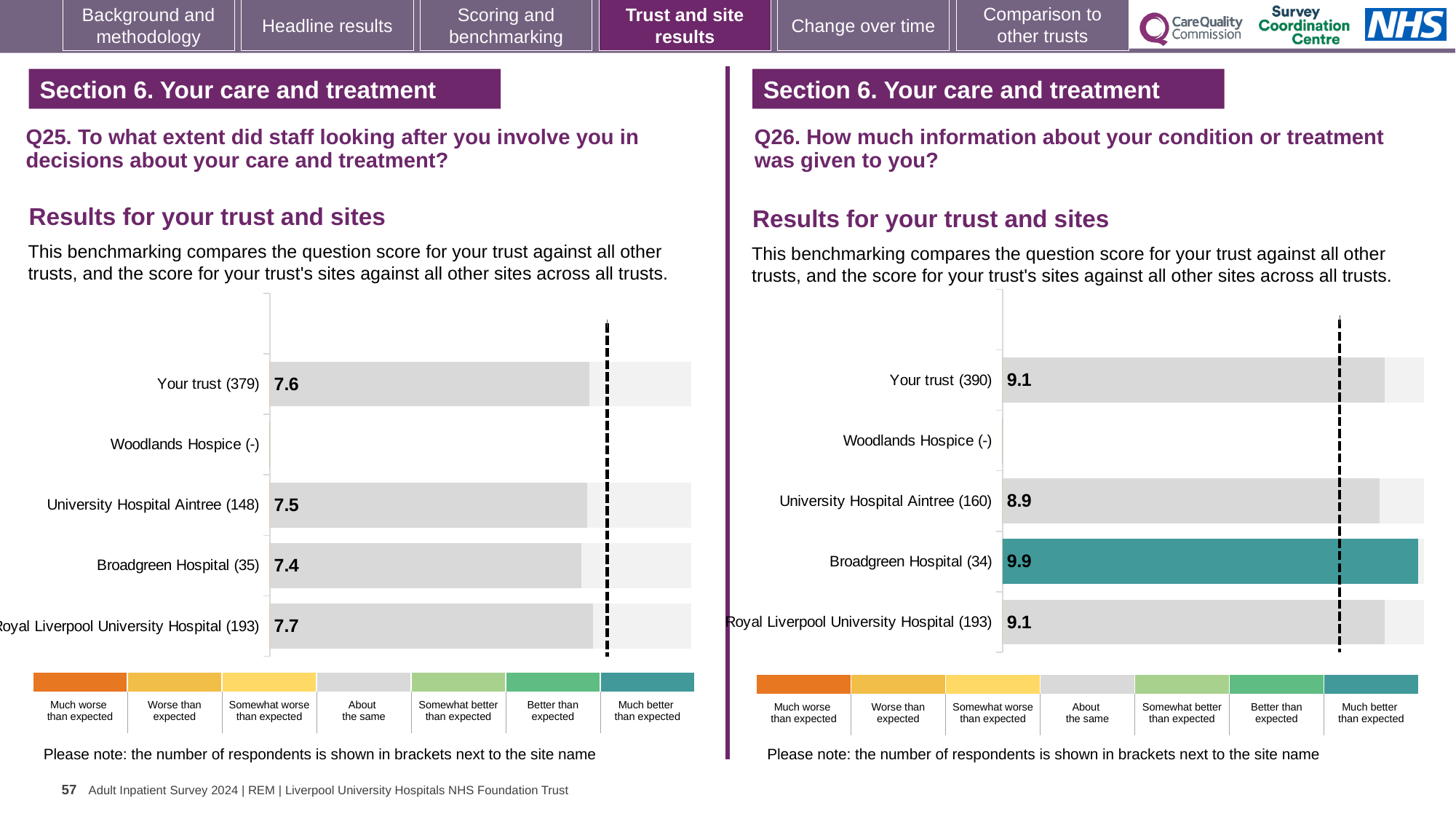
In the Q25 chart on the left, what is the score for Broadgreen Hospital? 7.4 In the Q25 chart on the left, what is the difference between the scores for Royal Liverpool University Hospital and Broadgreen Hospital? 0.3 In the Q26 chart on the right, what is the difference between the scores for Broadgreen Hospital and University Hospital Aintree? 1.0 In the Q26 chart on the right, which site or trust has the highest score? Broadgreen Hospital How many site or trust labels are listed on the Q25 chart on the left? 5 In the Q25 chart on the left, which site or trust has the lowest score? Broadgreen Hospital What kind of chart is used for the Q26 results on the right? Bar chart In the Q26 chart on the right, what is the score for Broadgreen Hospital? 9.9 In the Q25 chart on the left, which site or trust has the highest score? Royal Liverpool University Hospital In the Q26 chart on the right, which is larger: the score for Your trust or the score for University Hospital Aintree? Your trust In the Q26 chart on the right, what is the score for University Hospital Aintree? 8.9 In the Q25 chart on the left, what is the score for Your trust? 7.6